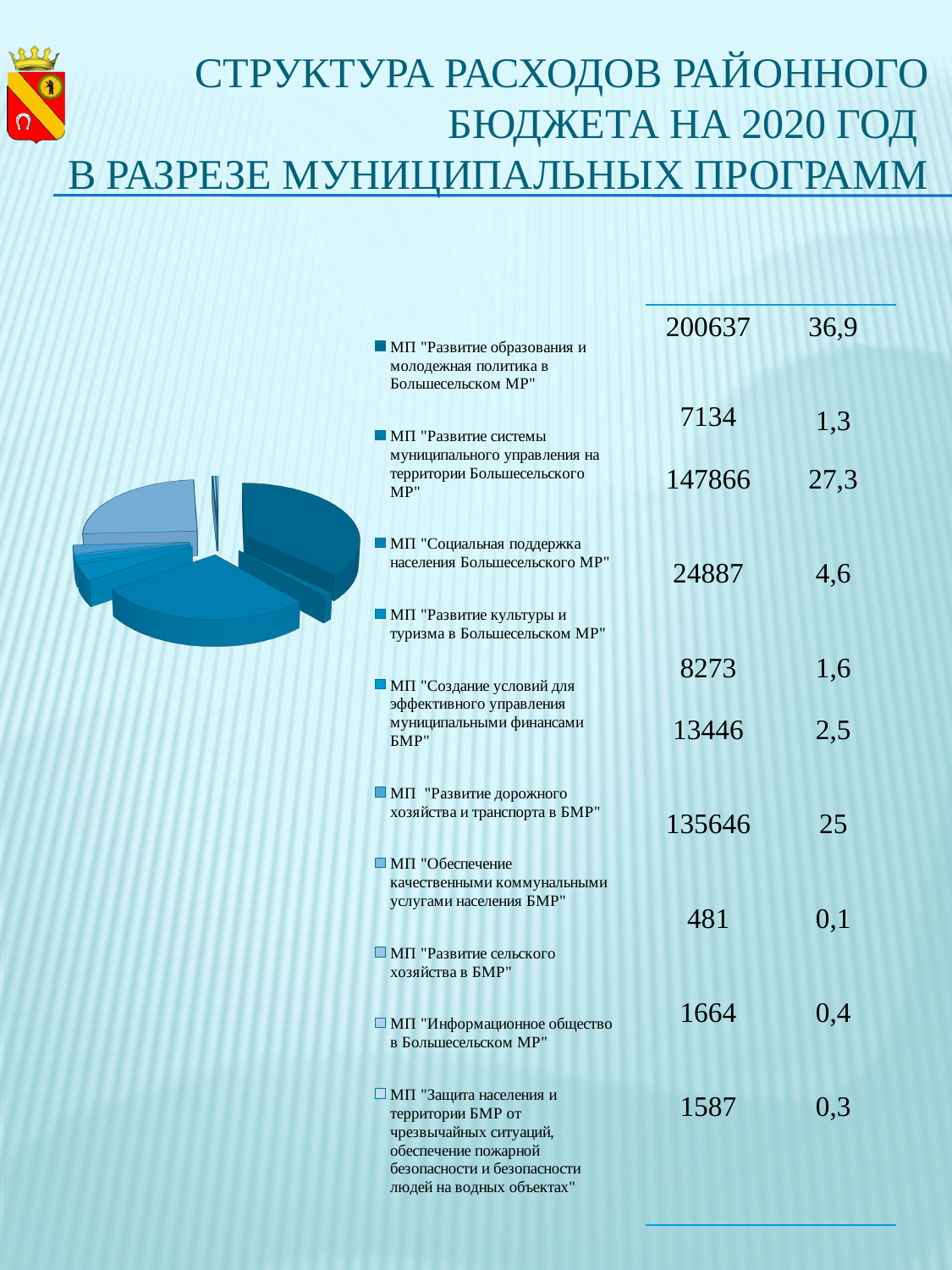
What percentage share is shown for МП "Обеспечение качественными коммунальными услугами населения БМР"? 25 What is the difference in percentage points between the share of МП "Развитие образования и молодежная политика в Большесельском МР" (36,9) and МП "Социальная поддержка населения Большесельского МР" (27,3)? 9,6 Which has the larger share: МП "Развитие образования и молодежная политика в Большесельском МР" or МП "Социальная поддержка населения Большесельского МР"? МП "Развитие образования и молодежная политика в Большесельском МР" Which municipal programme has the smallest share of the 2020 district budget expenditure? МП "Развитие сельского хозяйства в БМР" How many categories (municipal programmes) does the chart's legend list? 10 What percentage share is shown for МП "Развитие культуры и туризма в Большесельском МР"? 4,6 What amount is shown for МП "Социальная поддержка населения Большесельского МР"? 147866 What kind of chart is shown on the slide? pie chart What amount is shown for МП "Развитие сельского хозяйства в БМР"? 481 What percentage share is shown for МП "Развитие образования и молодежная политика в Большесельском МР"? 36,9 Which municipal programme has the largest share of the 2020 district budget expenditure? МП "Развитие образования и молодежная политика в Большесельском МР" What year does the slide title say the budget expenditure structure refers to? 2020